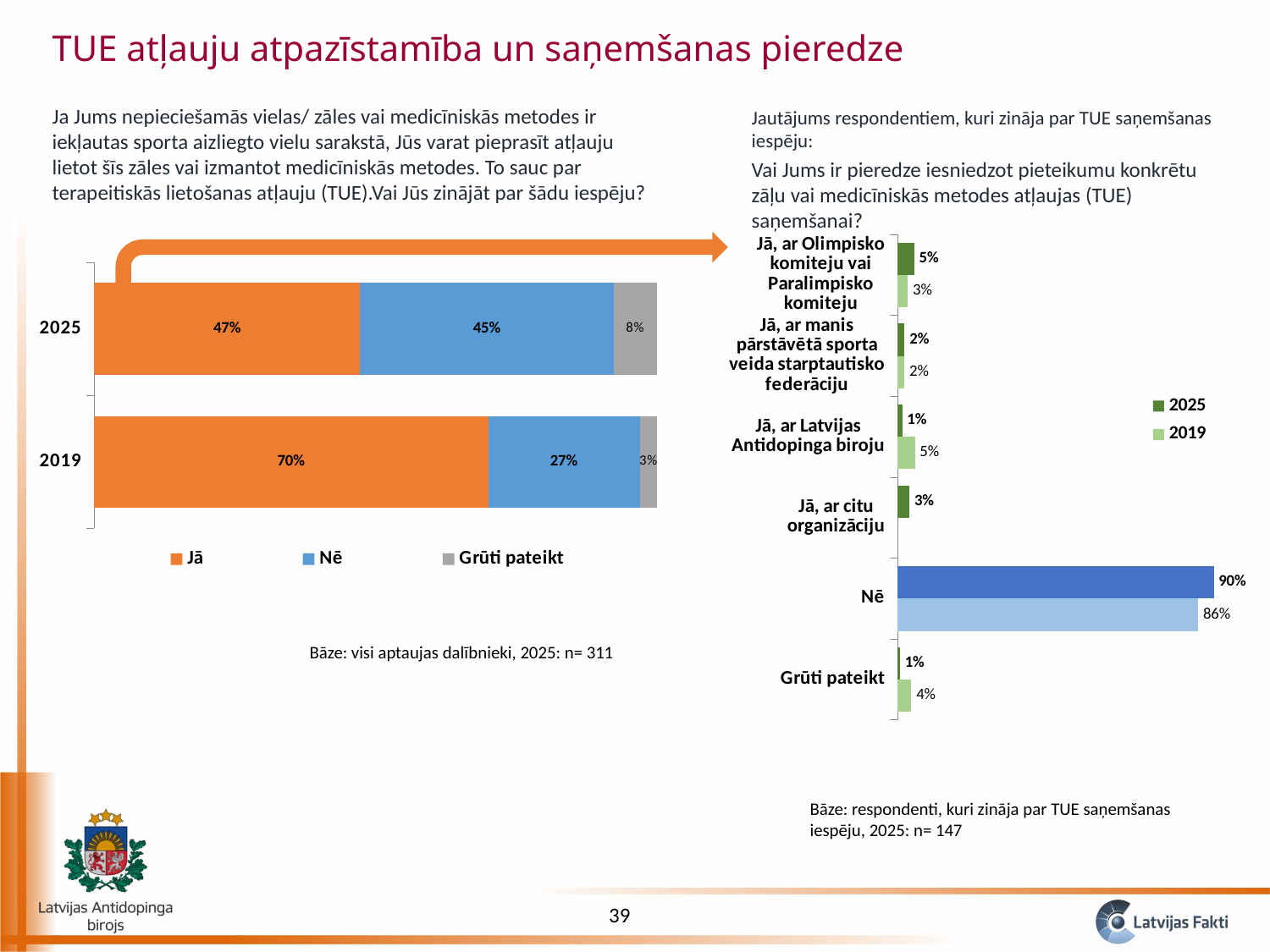
In the left chart, which year has the larger "Grūti pateikt" share, 2025 or 2019? 2025 In the left chart, how many series does the legend list? 3 In the right chart, what is the 2019 value for "Jā, ar Latvijas Antidopinga biroju"? 5% In the right chart, which category has the highest value in 2025? Nē In the right chart, which year has the larger value for "Grūti pateikt", 2025 or 2019? 2019 In the right chart, how many categories are shown on the vertical axis? 6 What kind of chart is the left chart? Stacked bar chart In the left chart, what percentage of respondents in 2025 answered "Jā"? 47% In the left chart, what is the difference between the "Jā" share in 2019 and in 2025? 23 percentage points In the right chart, what is the 2025 value for "Nē"? 90% In the right chart, what is the difference between the 2025 and 2019 values for "Nē"? 4 percentage points In the left chart, what percentage of respondents in 2019 answered "Nē"? 27%